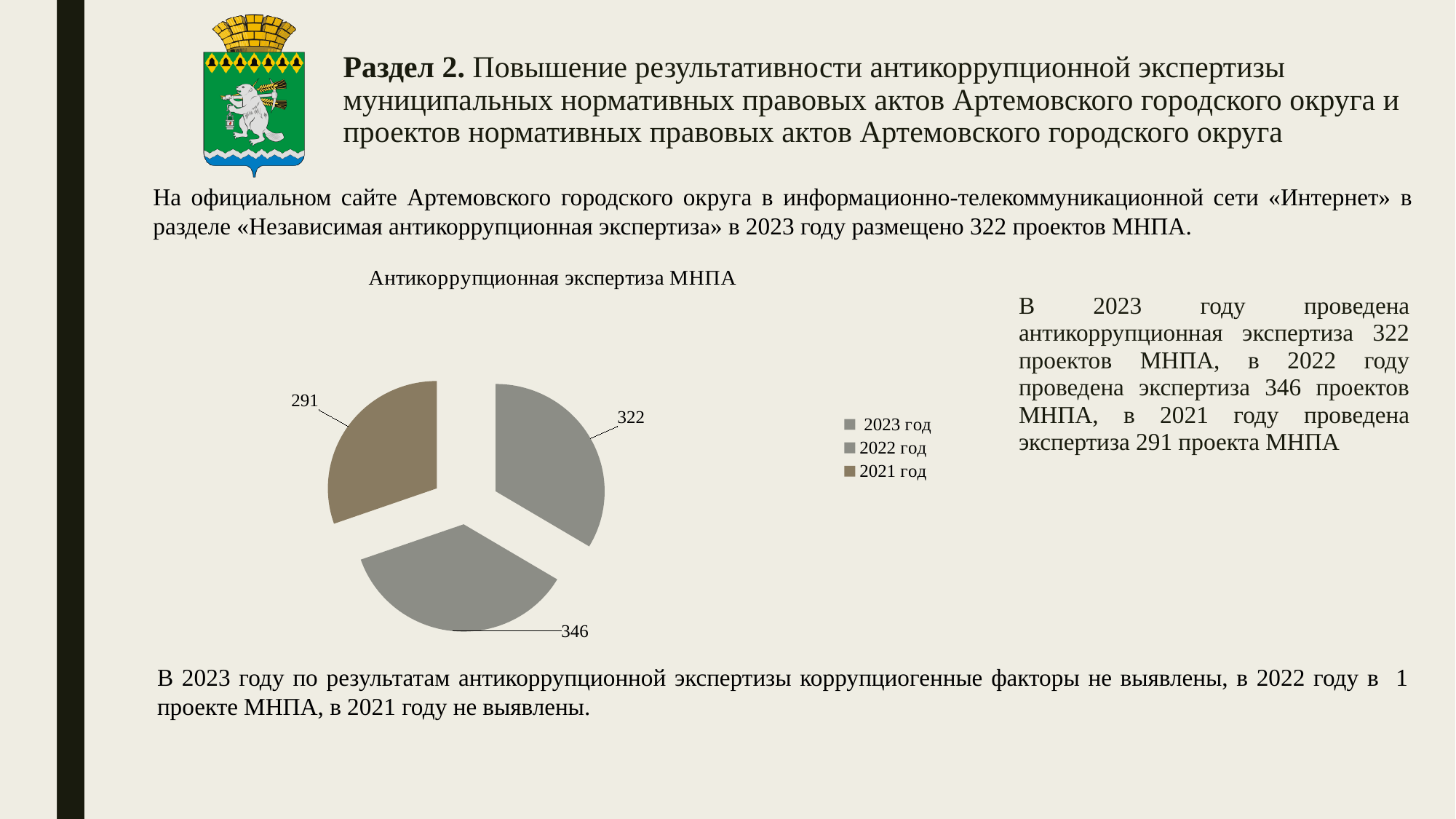
What kind of chart is shown on the slide? pie chart Which year has the smallest slice in the pie chart? 2021 год What is the value for 2021 год in the pie chart? 291 What is the difference between the values for 2023 год and 2021 год? 31 What is the value for 2022 год in the pie chart? 346 Which year has the largest slice in the pie chart? 2022 год How many slices does the pie chart have? 3 What is the title of the chart? Антикоррупционная экспертиза МНПА What is the difference between the values for 2022 год and 2023 год? 24 Which is larger, the value for 2023 год or the value for 2021 год? 2023 год How many entries does the chart legend list? 3 What is the value for 2023 год in the pie chart? 322